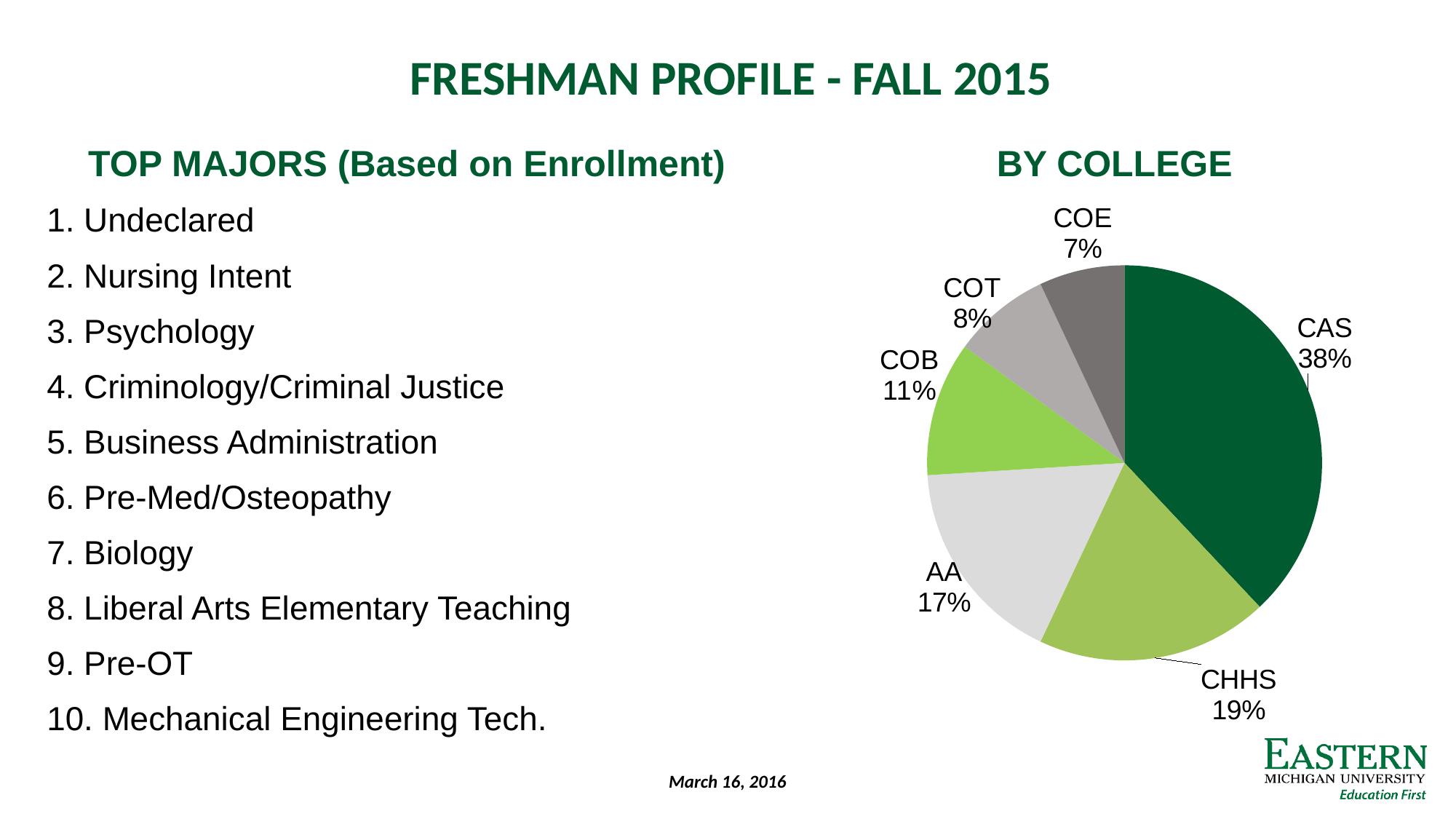
Which college has the smallest slice in the pie chart? COE What percentage does the pie chart show for CHHS? 19% Which is larger in the pie chart, COB or COT? COB What type of chart is shown under "BY COLLEGE"? pie chart What is the difference in percentage points between CAS and CHHS in the pie chart? 19 What percentage is shown for COB in the pie chart? 11% Which college has the largest slice in the pie chart? CAS What percentage is shown for COE in the pie chart? 7% What is the value shown for AA in the pie chart? 17% What share of freshmen is in CAS according to the pie chart? 38% How many slices does the pie chart have? 6 What is the title of the pie chart? BY COLLEGE